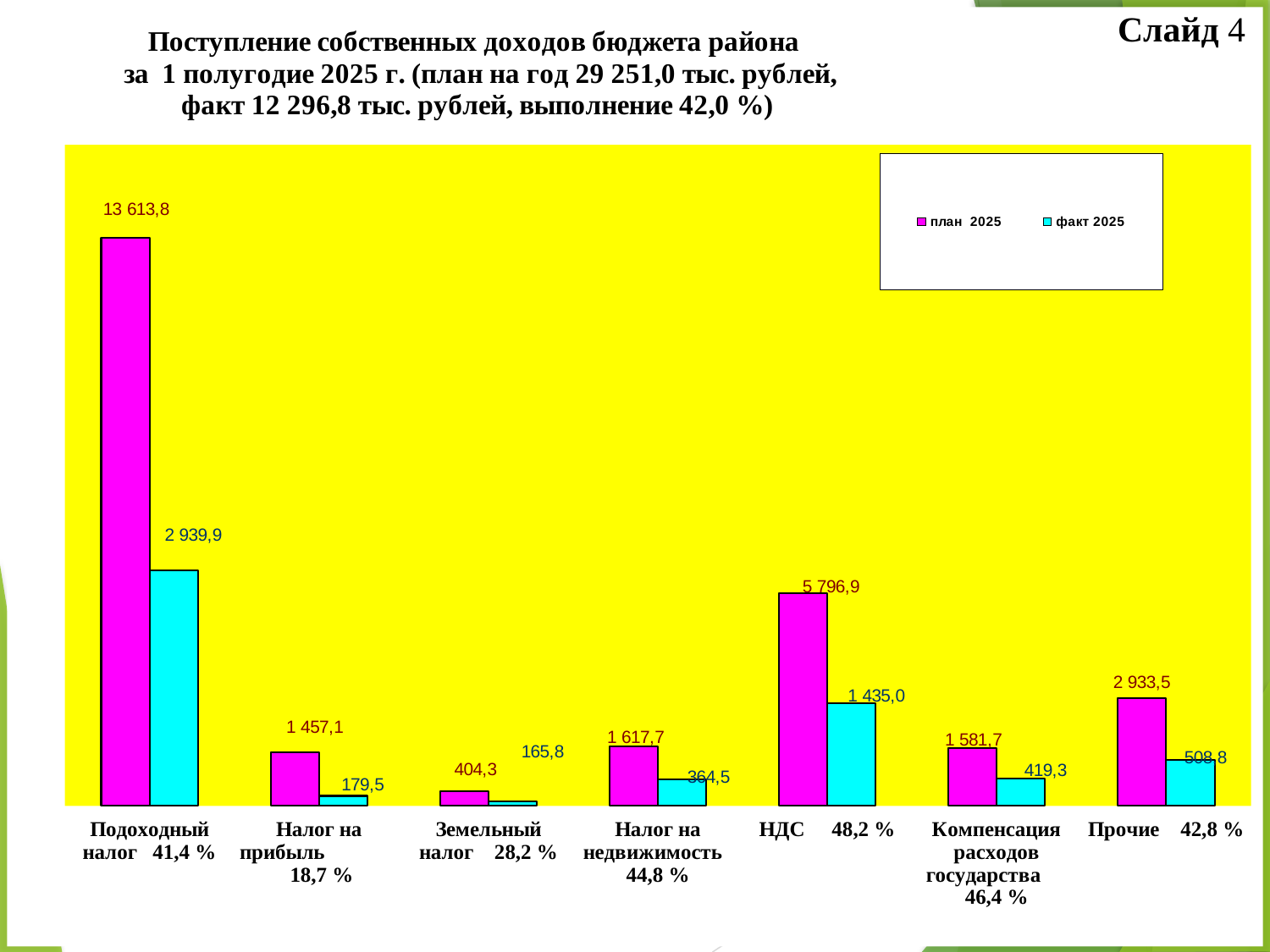
What is the difference between the план 2025 and факт 2025 values for Подоходный налог? 10 673,9 What is the факт 2025 value for НДС? 1 435,0 What is the план 2025 value for Компенсация расходов государства? 1 581,7 Which category has the highest план 2025 value? Подоходный налог What is the difference between the план 2025 and факт 2025 values for НДС? 4 361,9 Which category has the lowest факт 2025 value? Земельный налог How many categories are shown on the x axis? 7 Which is larger: the факт 2025 value for Прочие or the факт 2025 value for Компенсация расходов государства? Прочие What is the факт 2025 value for Земельный налог? 165,8 What kind of chart is shown on the slide? Bar chart How many series does the legend list? 2 What is the план 2025 value for Подоходный налог? 13 613,8